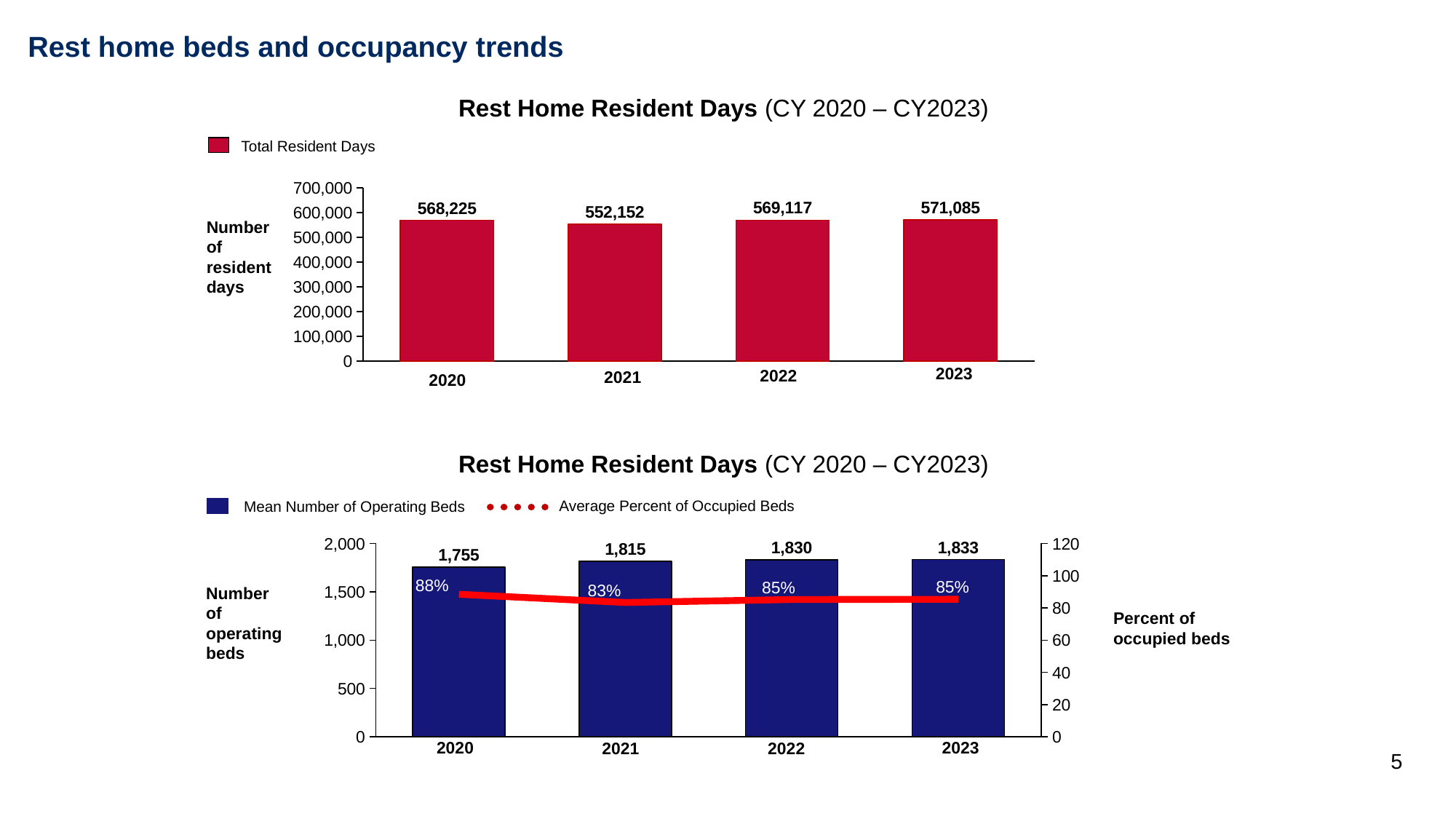
In the top chart, how many years are plotted? 4 How many series does the legend of the bottom chart list? 2 In the top chart, which year has the lowest Total Resident Days? 2021 In the bottom chart, does the Mean Number of Operating Beds rise or fall from 2020 to 2023? Rise In the top chart, what is the value of Total Resident Days for 2021? 552,152 In the top chart, which year has the highest Total Resident Days? 2023 In the bottom chart, what is the Average Percent of Occupied Beds for 2020? 88% What kind of chart is the top chart? Bar chart In the bottom chart, what is the difference in Mean Number of Operating Beds between 2021 and 2020? 60 In the top chart, what is the difference in Total Resident Days between 2023 and 2020? 2,860 In the bottom chart, which year has the lowest Average Percent of Occupied Beds? 2021 In the bottom chart, what is the Mean Number of Operating Beds for 2022? 1,830